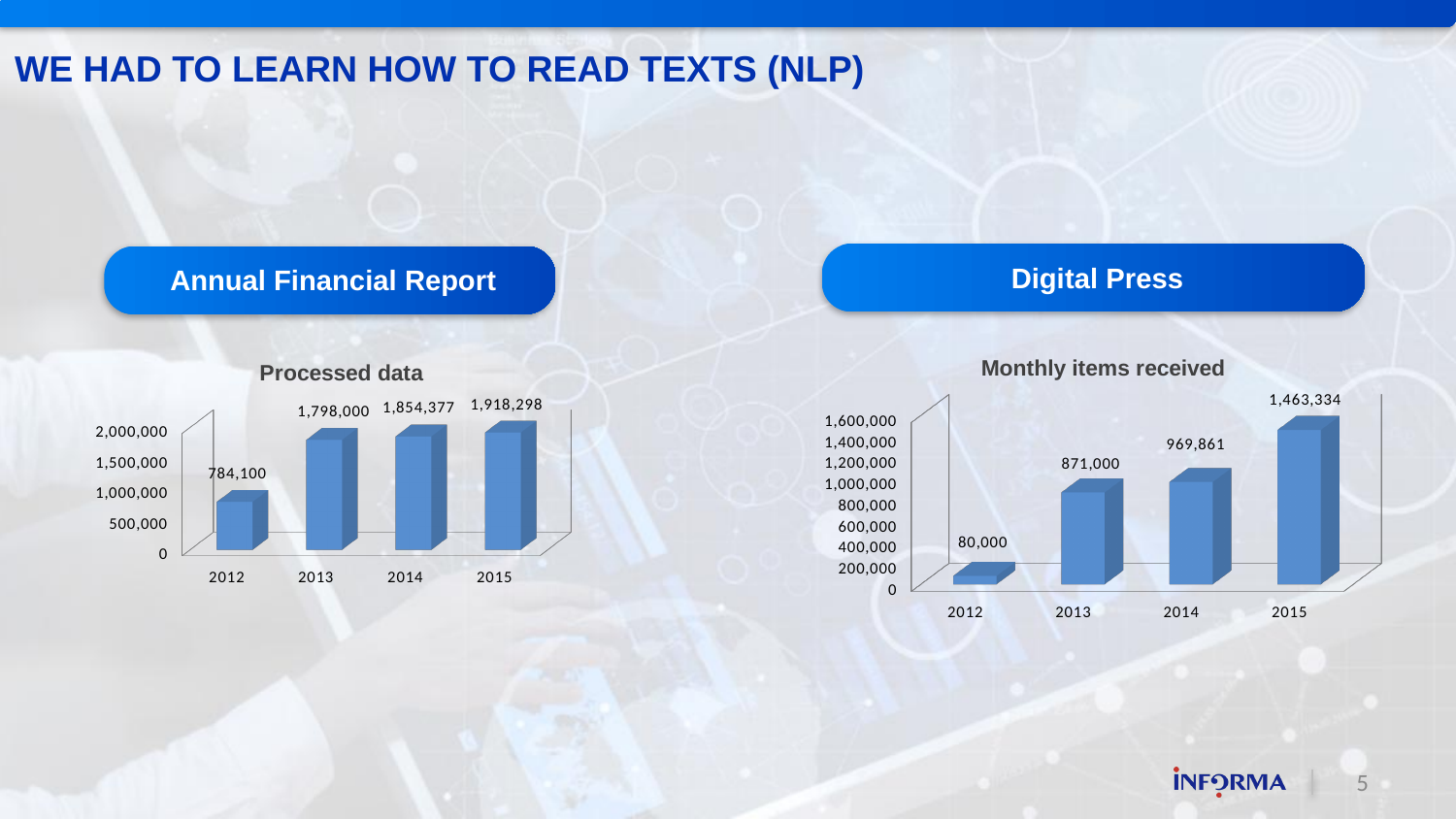
In the 'Processed data' chart, what is the value for 2012? 784,100 In the 'Monthly items received' chart, what is the difference between the 2015 and 2014 values? 493,473 In the 'Processed data' chart, which year has the highest value? 2015 In the 'Monthly items received' chart, what is the value for 2013? 871,000 In the 'Monthly items received' chart, what is the value for 2015? 1,463,334 In the 'Monthly items received' chart, do the values rise or fall from 2012 to 2015? Rise In the 'Monthly items received' chart, which is larger, the value for 2013 or the value for 2014? 2014 In the 'Monthly items received' chart, which year has the lowest value? 2012 How many years are shown on the x axis of the 'Processed data' chart? 4 What kind of chart is the 'Monthly items received' chart? Bar chart In the 'Processed data' chart, what is the difference between the 2015 and 2012 values? 1,134,198 In the 'Processed data' chart, what is the value for 2014? 1,854,377